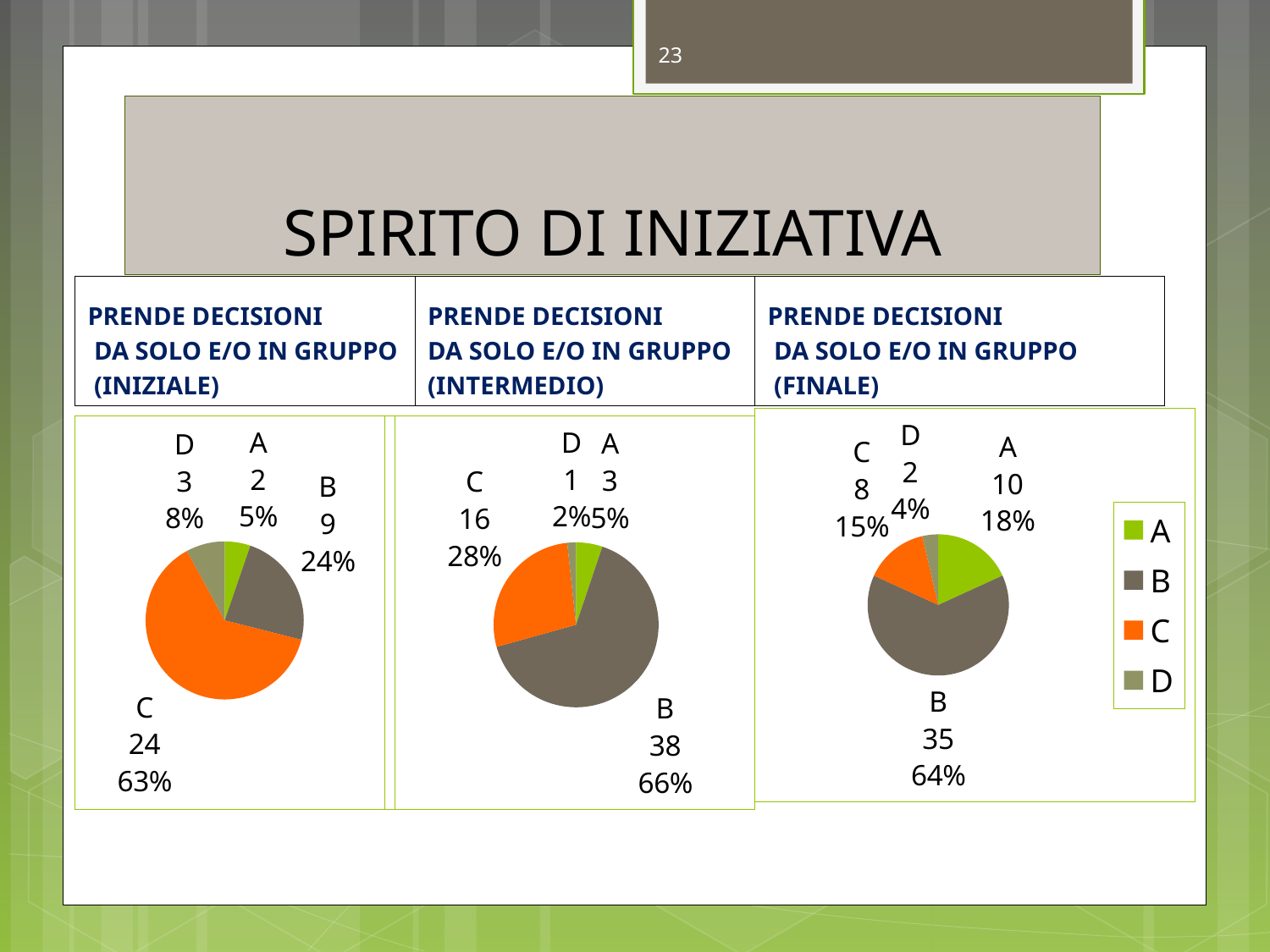
What type of chart is used in the INIZIALE, INTERMEDIO and FINALE panels? Pie chart In the FINALE chart, what is the value for category B? 35 How many categories does the legend on the right list? 4 In the INIZIALE chart, what is the value for category C? 24 In the legend, which colour represents category C? Orange In the INTERMEDIO chart, what is the difference between the values for B and C? 22 In the INIZIALE chart, what percentage share does category B have? 24% In the FINALE chart, which is larger, the value for A or the value for C? A In the INTERMEDIO chart, which category has the smallest slice? D In the FINALE chart, what percentage share does category A have? 18% In the INIZIALE chart, which category has the largest slice? C In the INTERMEDIO chart, what is the value for category B? 38